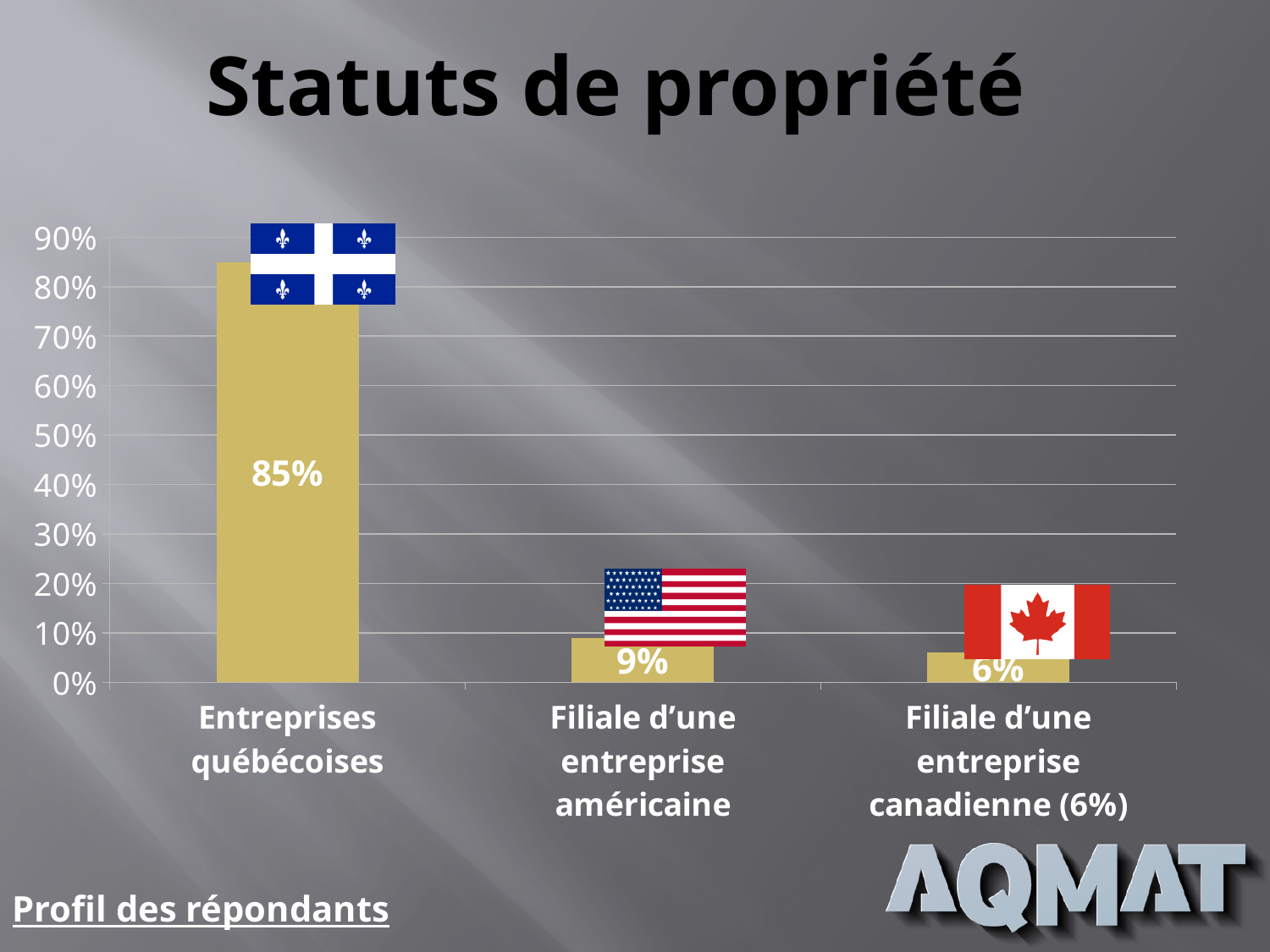
Which is larger, the value for Filiale d'une entreprise américaine or Filiale d'une entreprise canadienne? Filiale d'une entreprise américaine What is the difference between the values for Filiale d'une entreprise américaine and Filiale d'une entreprise canadienne? 3% What is the value for Filiale d'une entreprise canadienne? 6% What is the value for Filiale d'une entreprise américaine? 9% What is the title of the chart? Statuts de propriété Which category has the highest value? Entreprises québécoises Is the value for Entreprises québécoises greater or less than 80%? greater What is the value for Entreprises québécoises? 85% How many categories are shown in the chart? 3 Which category has the lowest value? Filiale d'une entreprise canadienne What kind of chart is shown on the slide? bar chart What is the difference between the values for Entreprises québécoises and Filiale d'une entreprise américaine? 76%